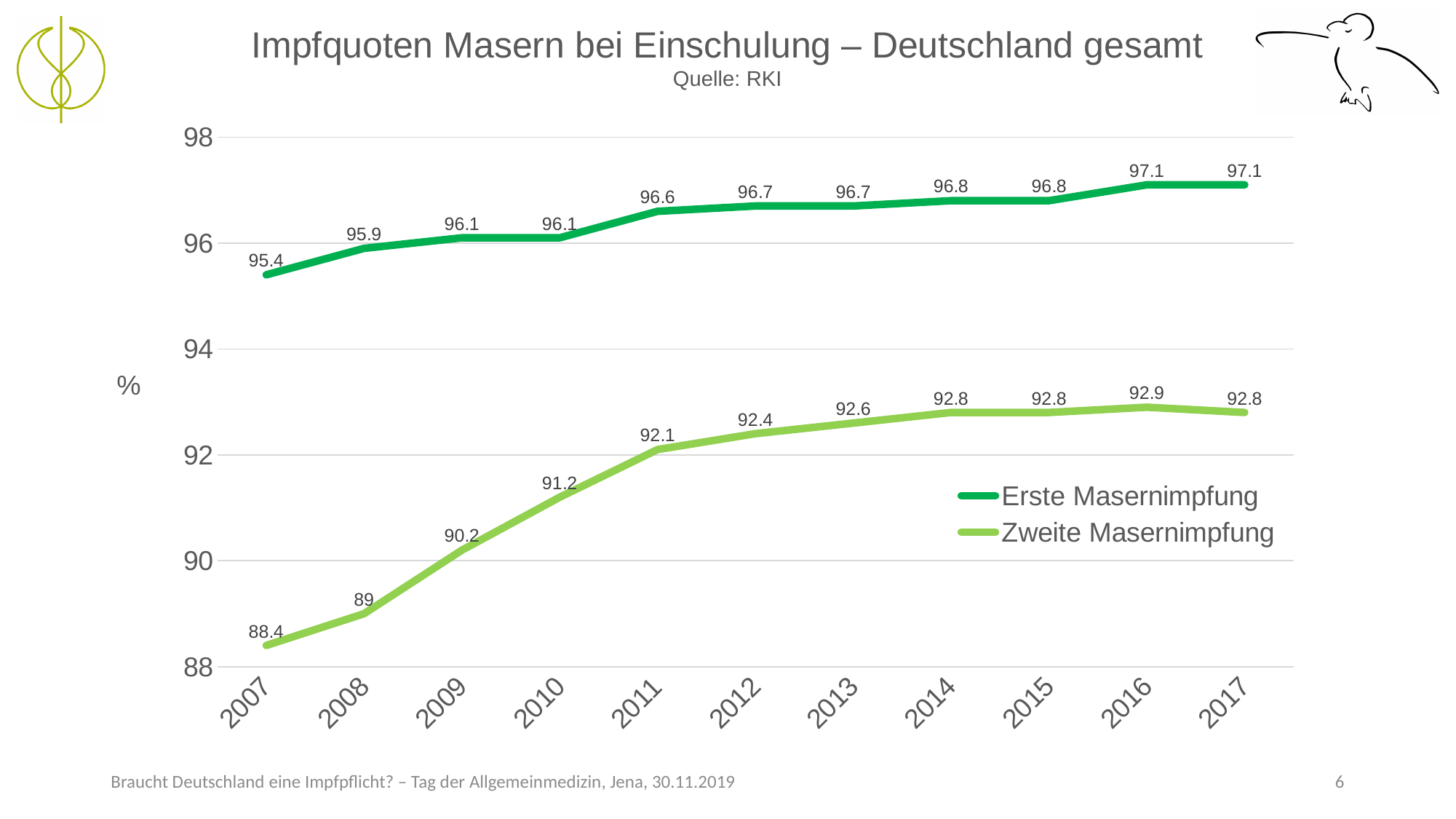
How many series does the legend list? 2 Does the Erste Masernimpfung series generally rise or fall from 2007 to 2017? Rise Which is larger: Zweite Masernimpfung in 2010 or in 2009? 2010 What kind of chart is shown on the slide? Line chart What is the difference between Erste Masernimpfung and Zweite Masernimpfung in 2017? 4.3 How many years are shown on the x axis? 11 What is the value for Zweite Masernimpfung in 2011? 92.1 What is the value for Erste Masernimpfung in 2007? 95.4 In which year is the Zweite Masernimpfung value highest? 2016 What is the difference between the Zweite Masernimpfung values in 2017 and 2007? 4.4 In which year is the Zweite Masernimpfung value lowest? 2007 What is the value for Zweite Masernimpfung in 2008? 89